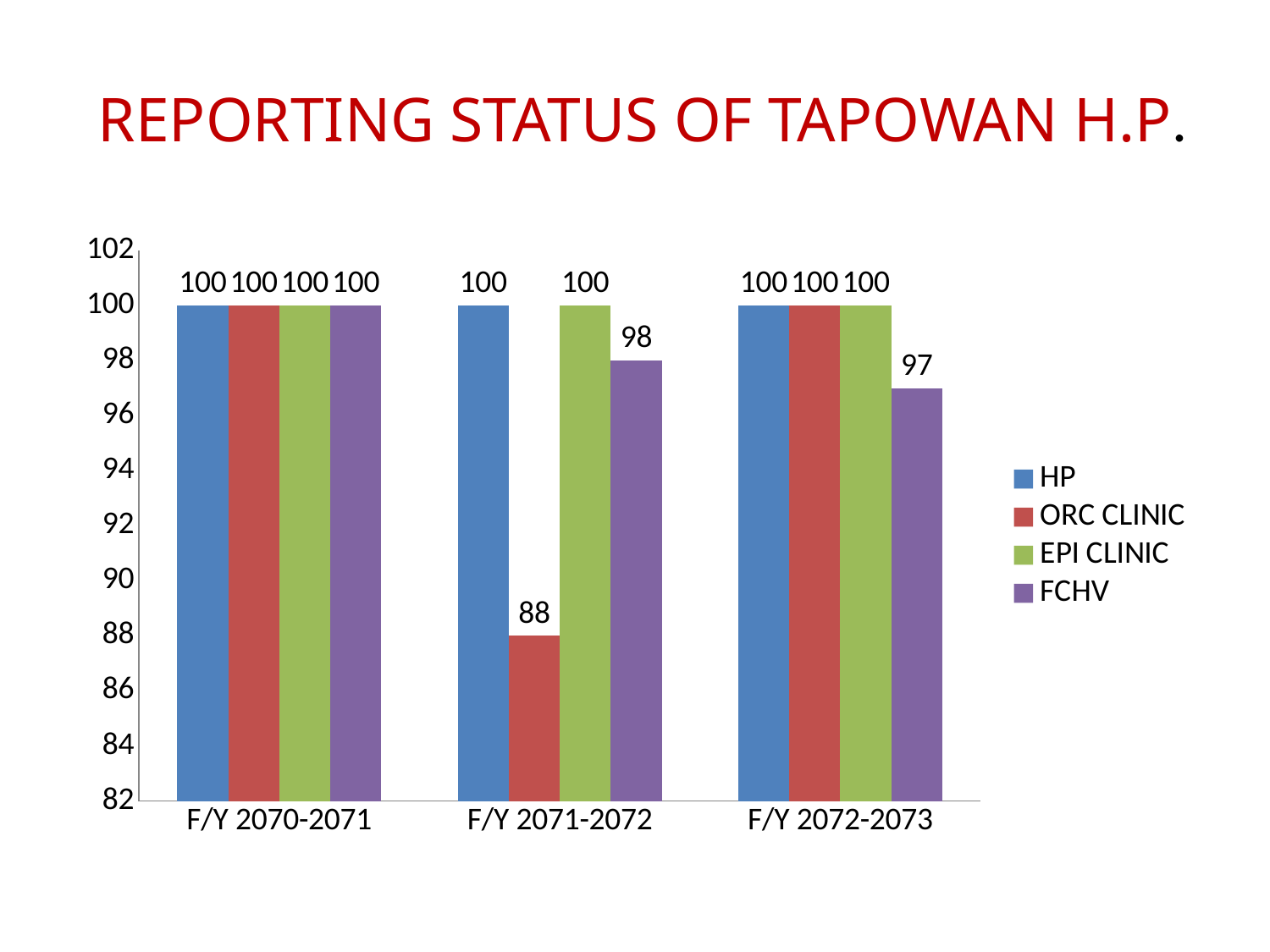
Which series has the lowest value in F/Y 2071-2072? ORC CLINIC Which series has the lowest value in F/Y 2072-2073? FCHV What kind of chart is shown on the slide? Bar chart Does the FCHV value rise or fall across the fiscal years from F/Y 2070-2071 to F/Y 2072-2073? Fall What is the value for HP in F/Y 2070-2071? 100 How many fiscal year categories are shown on the x axis? 3 How many series does the legend list? 4 What is the value for FCHV in F/Y 2072-2073? 97 What is the value for ORC CLINIC in F/Y 2071-2072? 88 What is the difference between the EPI CLINIC and ORC CLINIC values in F/Y 2071-2072? 12 Which is larger, the FCHV value in F/Y 2071-2072 or the FCHV value in F/Y 2072-2073? F/Y 2071-2072 What is the value for FCHV in F/Y 2071-2072? 98